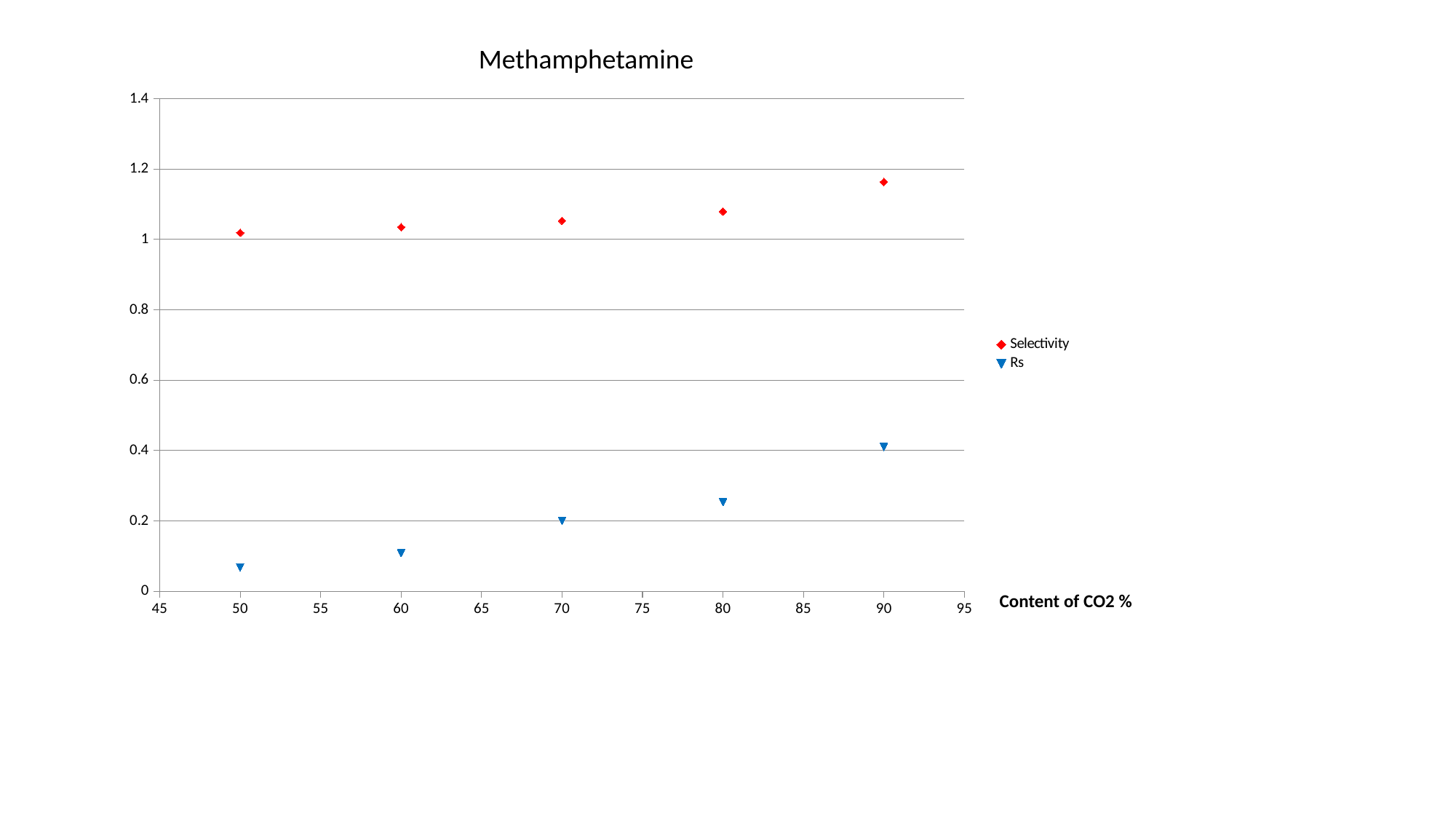
What is the label of the x axis? Content of CO2 % At a CO2 content of 90, which series has the larger value, Selectivity or Rs? Selectivity At which CO2 content is the Selectivity value highest? 90 What is the title of the chart? Methamphetamine How many data points are plotted for the Selectivity series? 5 Is the Rs value at a CO2 content of 50 greater or less than 0.2? less At which CO2 content is the Rs value lowest? 50 What kind of chart is shown on the slide? scatter chart How many series does the legend list? 2 Is the Rs value at a CO2 content of 80 greater or less than 0.2? greater Do the Rs values rise or fall as the CO2 content increases from 50 to 90? rise Is the Selectivity value at a CO2 content of 90 greater or less than 1? greater